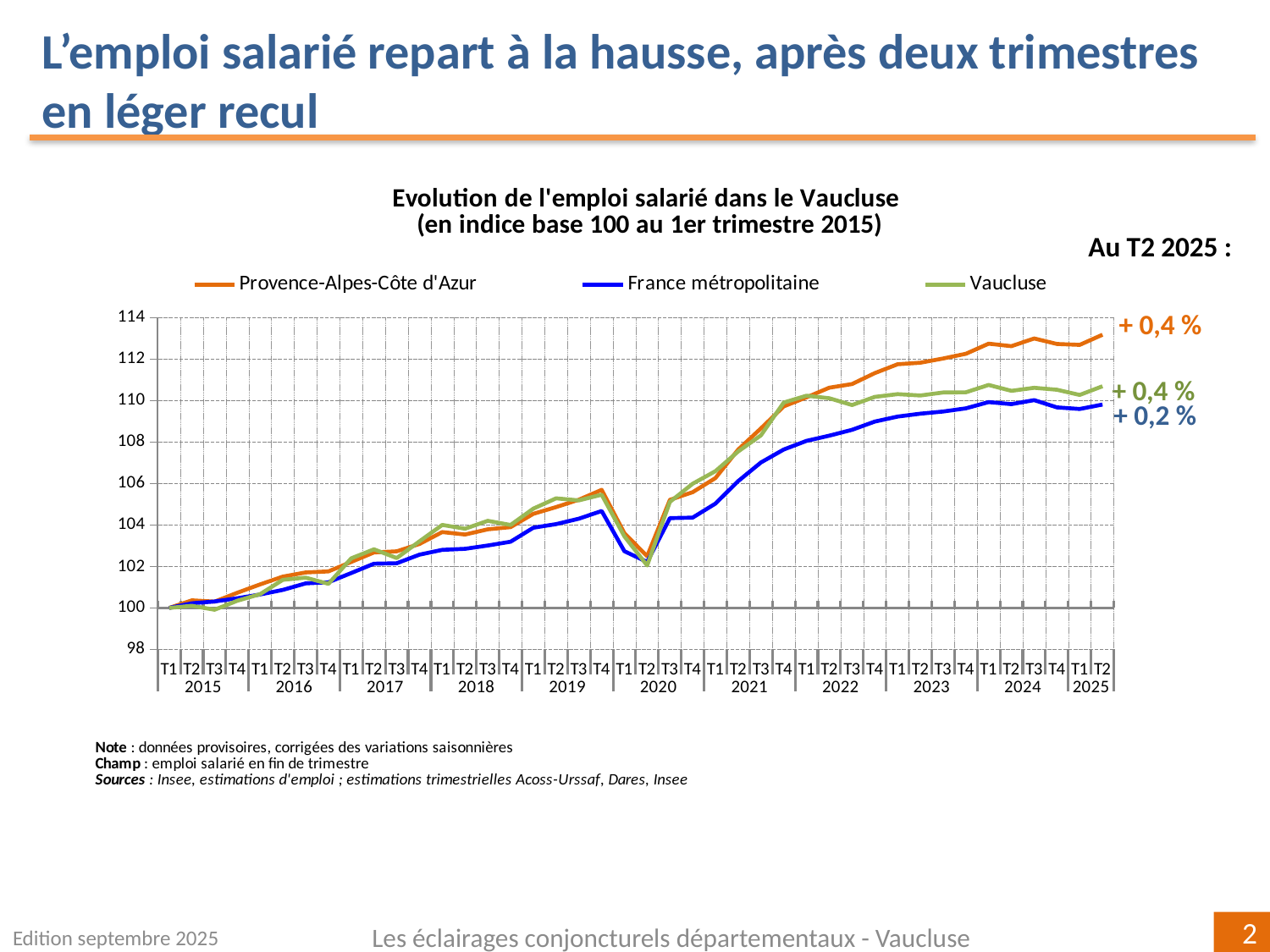
Is the value for Vaucluse at T2 2020 greater or less than 104? less What change is printed next to the France métropolitaine line for T2 2025? + 0,2 % What kind of chart is shown on the slide? line chart What change is printed next to the Vaucluse line for T2 2025? + 0,4 % Overall, do the index values rise or fall from T1 2015 to T2 2025? rise What is the title of the chart? Evolution de l'emploi salarié dans le Vaucluse (en indice base 100 au 1er trimestre 2015) Which series has the highest value at T2 2025? Provence-Alpes-Côte d'Azur Is the value for Provence-Alpes-Côte d'Azur at T2 2025 greater or less than 112? greater How many series does the legend list? 3 At T2 2025, which series is higher: Provence-Alpes-Côte d'Azur or France métropolitaine? Provence-Alpes-Côte d'Azur What change is printed next to the Provence-Alpes-Côte d'Azur line for T2 2025? + 0,4 %